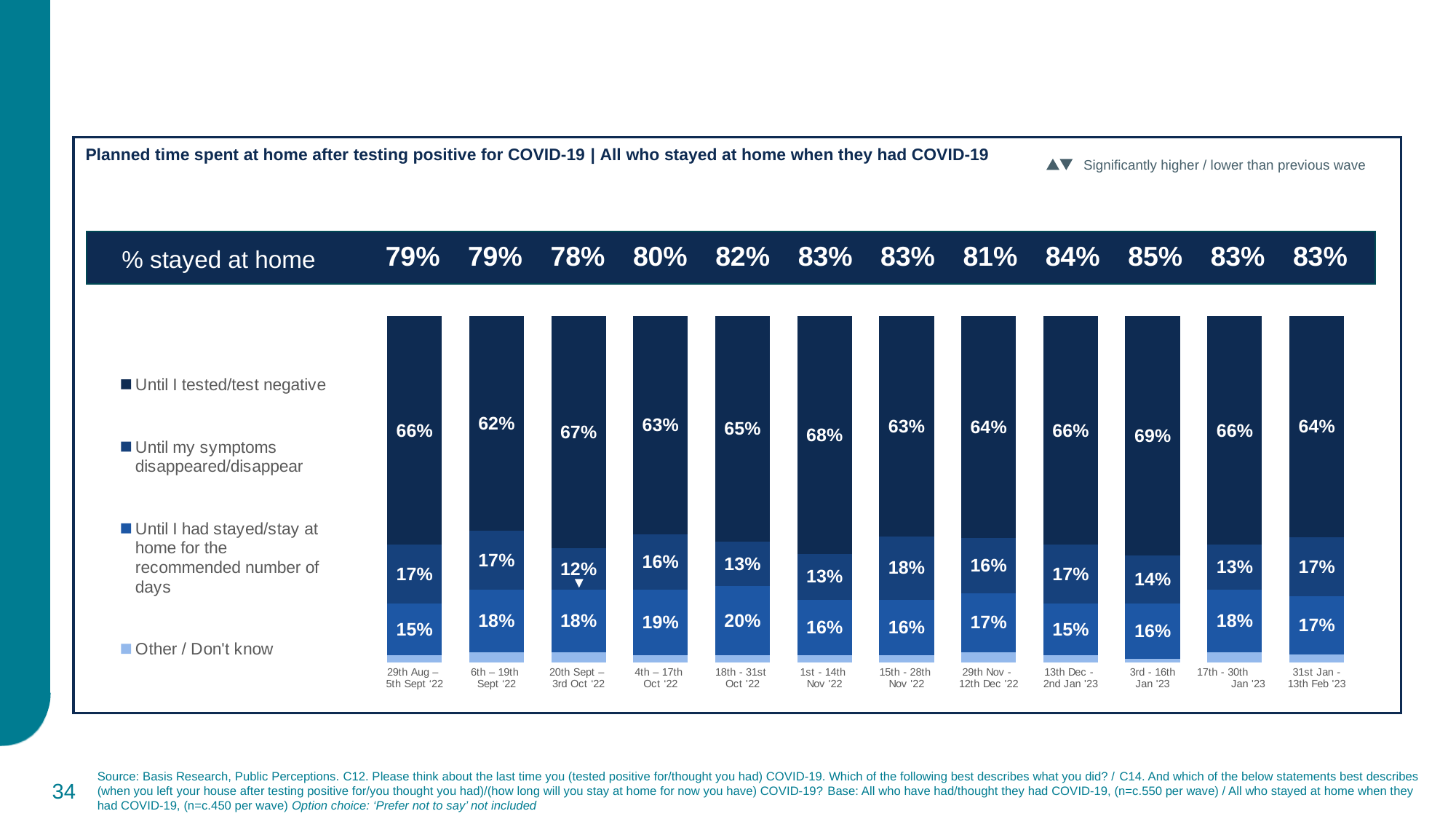
How many survey waves (bars) are shown in the chart? 12 What percentage said 'Until I tested/test negative' in the 31st Jan - 13th Feb '23 wave? 64% How many series does the legend list? 4 What is the difference between the highest and lowest 'Until I tested/test negative' values across the waves? 7 percentage points In which wave was the 'Until I tested/test negative' share lowest? 6th – 19th Sept '22 In which wave was the 'Until my symptoms disappeared/disappear' share lowest? 20th Sept – 3rd Oct '22 What is the '% stayed at home' figure shown for the 3rd - 16th Jan '23 wave? 85% Which wave has the larger 'Until I tested/test negative' share: 29th Aug – 5th Sept '22 or 6th – 19th Sept '22? 29th Aug – 5th Sept '22 In which wave was the 'Until I tested/test negative' share highest? 3rd - 16th Jan '23 What percentage said 'Until I had stayed/stay at home for the recommended number of days' in the 18th - 31st Oct '22 wave? 20% What percentage said 'Until my symptoms disappeared/disappear' in the 15th - 28th Nov '22 wave? 18% What kind of chart is shown on the slide? Stacked bar chart